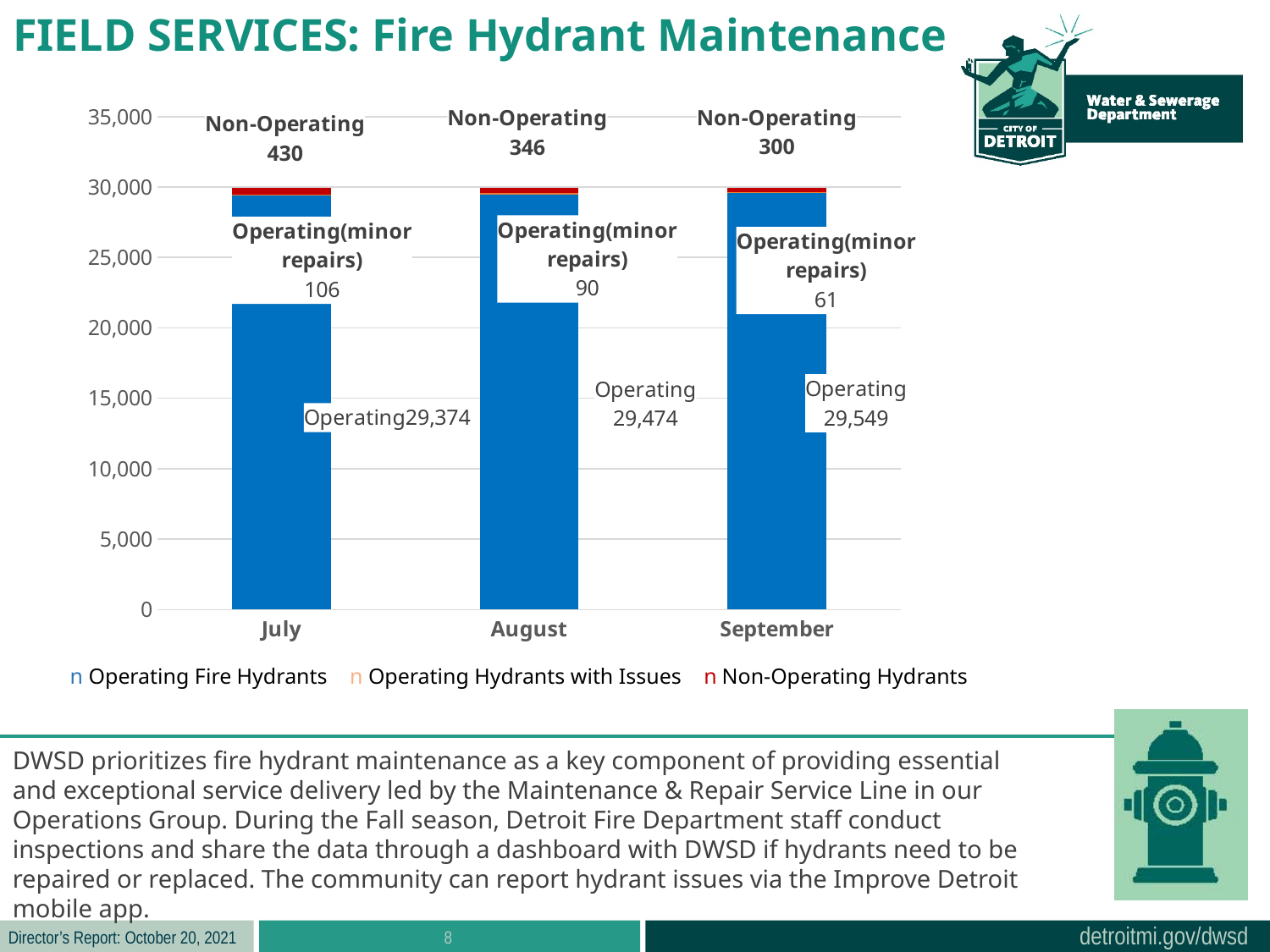
What is the number of Operating fire hydrants in July? 29,374 Do the Non-Operating hydrant counts rise or fall from July to September? Fall How many months are shown on the x axis? 3 Which month has the lowest number of Operating (minor repairs) hydrants? September Is the Operating hydrant count larger in August or September? September How many series does the legend list? 3 What is the Non-Operating hydrant count for August? 346 How many Operating (minor repairs) hydrants are shown for September? 61 Is the Operating value for July greater or less than 25,000? greater What kind of chart is shown on the slide? Stacked bar chart What is the difference between the Non-Operating counts for July and September? 130 Which month has the highest Non-Operating hydrant count? July